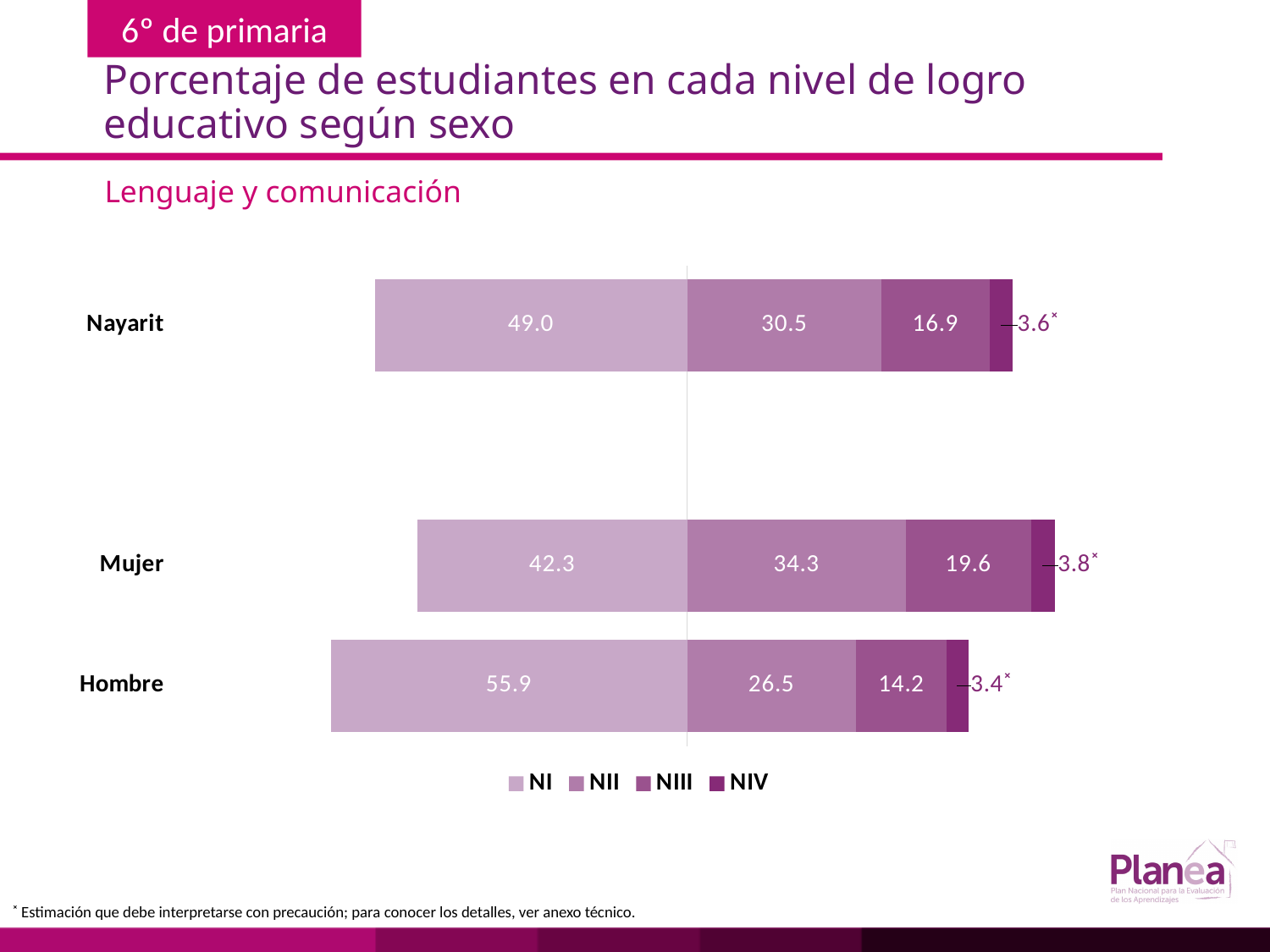
What type of chart is shown on the slide? Stacked bar chart How many series does the legend list? 4 Which category has the lowest NIII value? Hombre What is the difference between the NI values for Hombre and Mujer? 13.6 Which category has the highest NI value? Hombre What is the NII value for Mujer? 34.3 What is the NI value for Hombre? 55.9 What is the NIV value for Hombre? 3.4 How many categories are plotted on the chart? 3 Which is larger, the NII value for Nayarit or the NII value for Hombre? Nayarit What is the subtitle shown above the chart? Lenguaje y comunicación What is the NIII value for Nayarit? 16.9